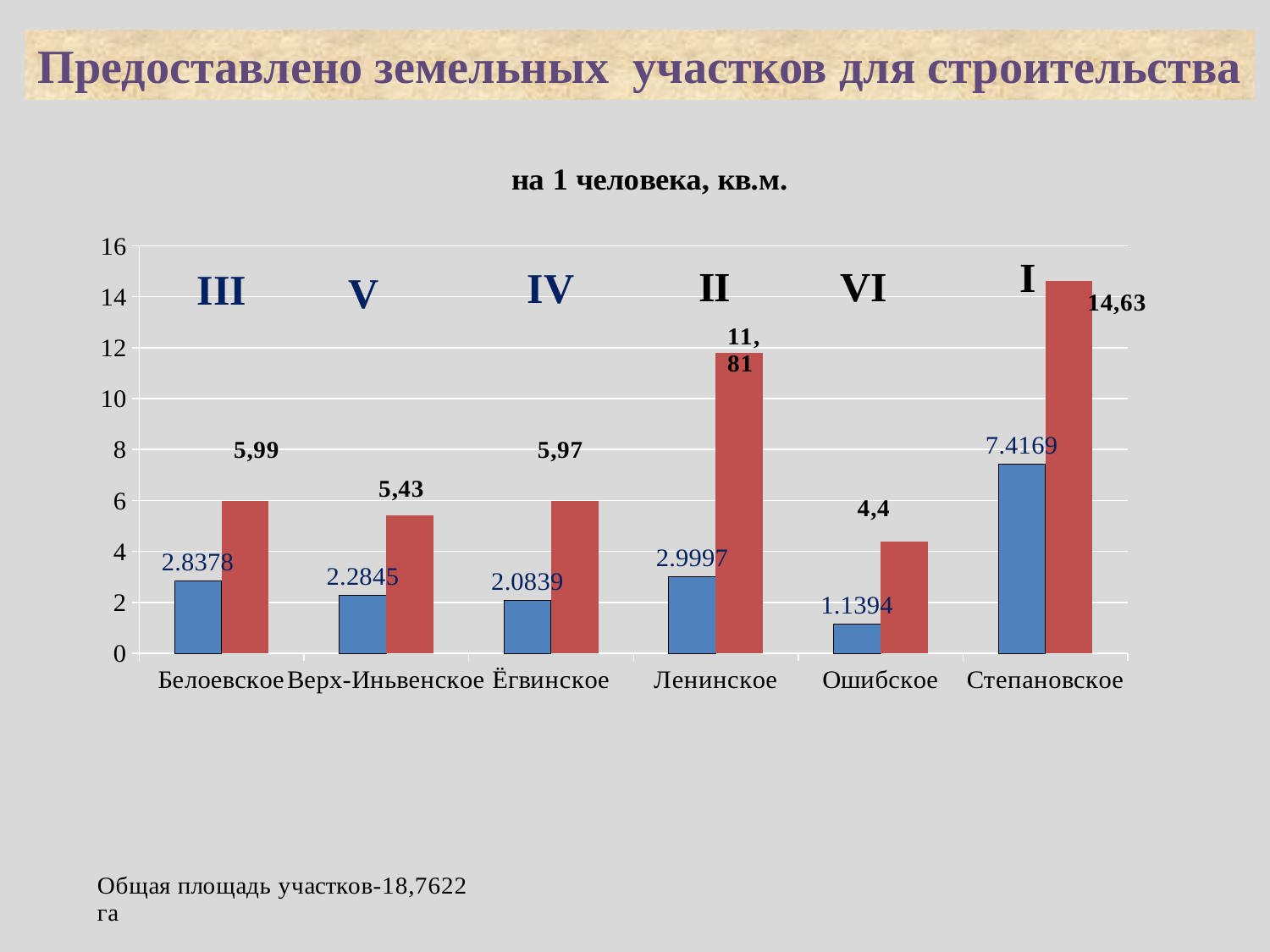
Is the red bar value for Ленинское greater or less than 10? greater What is the value of the blue bar for Ошибское? 1.1394 Which has the larger red bar, Ошибское or Верх-Иньвенское? Верх-Иньвенское What is the difference between the red bar values for Белоевское and Ёгвинское? 0,02 Which category has the highest red bar? Степановское How many categories are shown on the x axis? 6 What is the value of the blue bar for Степановское? 7.4169 Which category has the lowest blue bar? Ошибское What Roman numeral is printed above the bars for Степановское? I What kind of chart is shown on the slide? bar chart What is the value of the red bar for Ленинское? 11,81 What is the difference between the red bar values for Степановское and Ленинское? 2,82